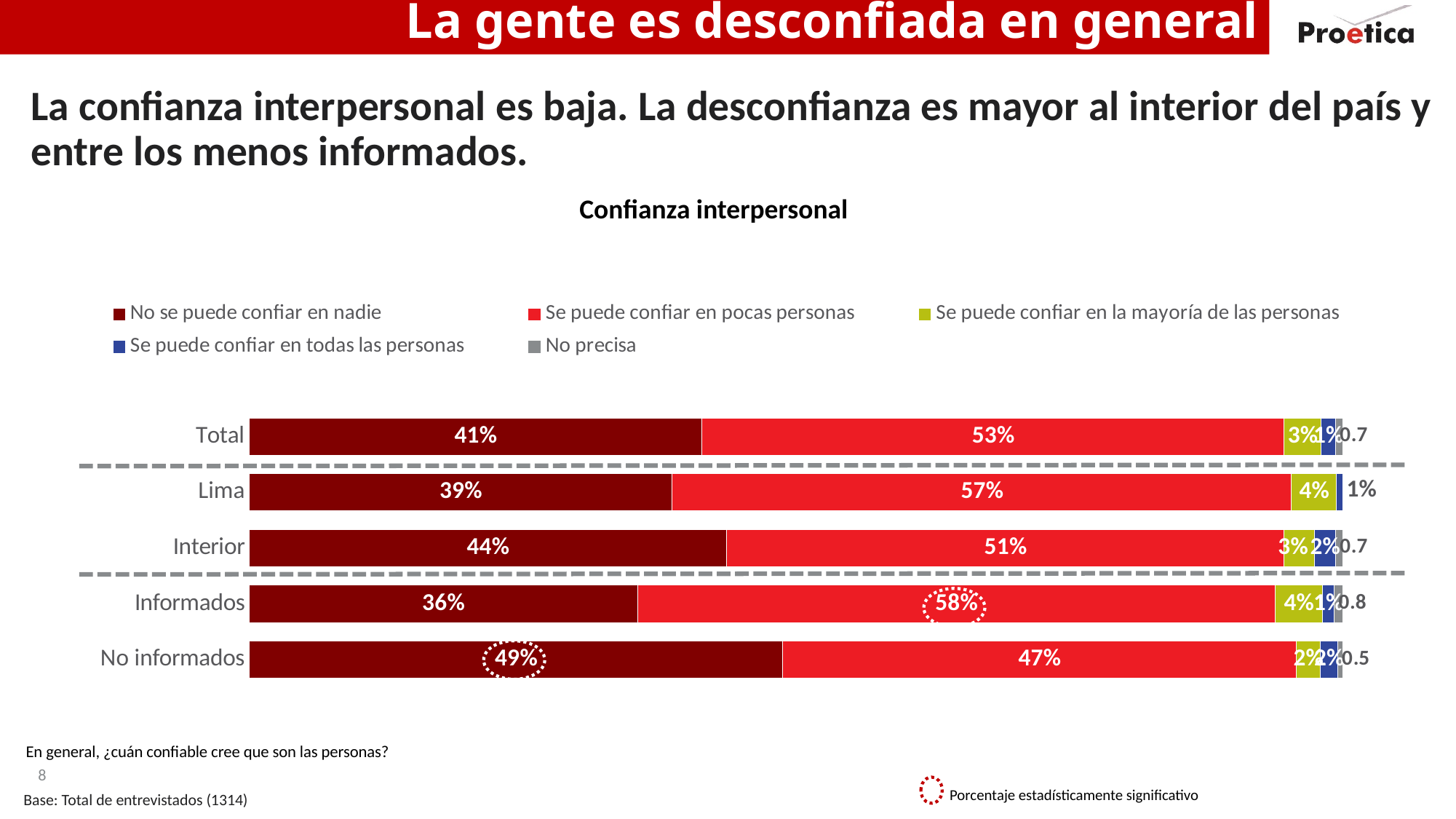
What is the value of 'No se puede confiar en nadie' for Total? 41% Which is larger for No informados: 'No se puede confiar en nadie' or 'Se puede confiar en pocas personas'? No se puede confiar en nadie How many categories (bars) does the chart show? 5 How many series does the legend list? 5 What is the difference between the 'No se puede confiar en nadie' values for Interior and Lima? 5% What is the value of 'Se puede confiar en pocas personas' for Lima? 57% What type of chart is shown under the title 'Confianza interpersonal'? stacked bar chart Which legend entry is shown in blue? Se puede confiar en todas las personas What is the value of 'No se puede confiar en nadie' for Interior? 44% Which category has the highest value for 'No se puede confiar en nadie'? No informados What is the value of 'Se puede confiar en pocas personas' for Informados? 58% Which category has the lowest value for 'No se puede confiar en nadie'? Informados